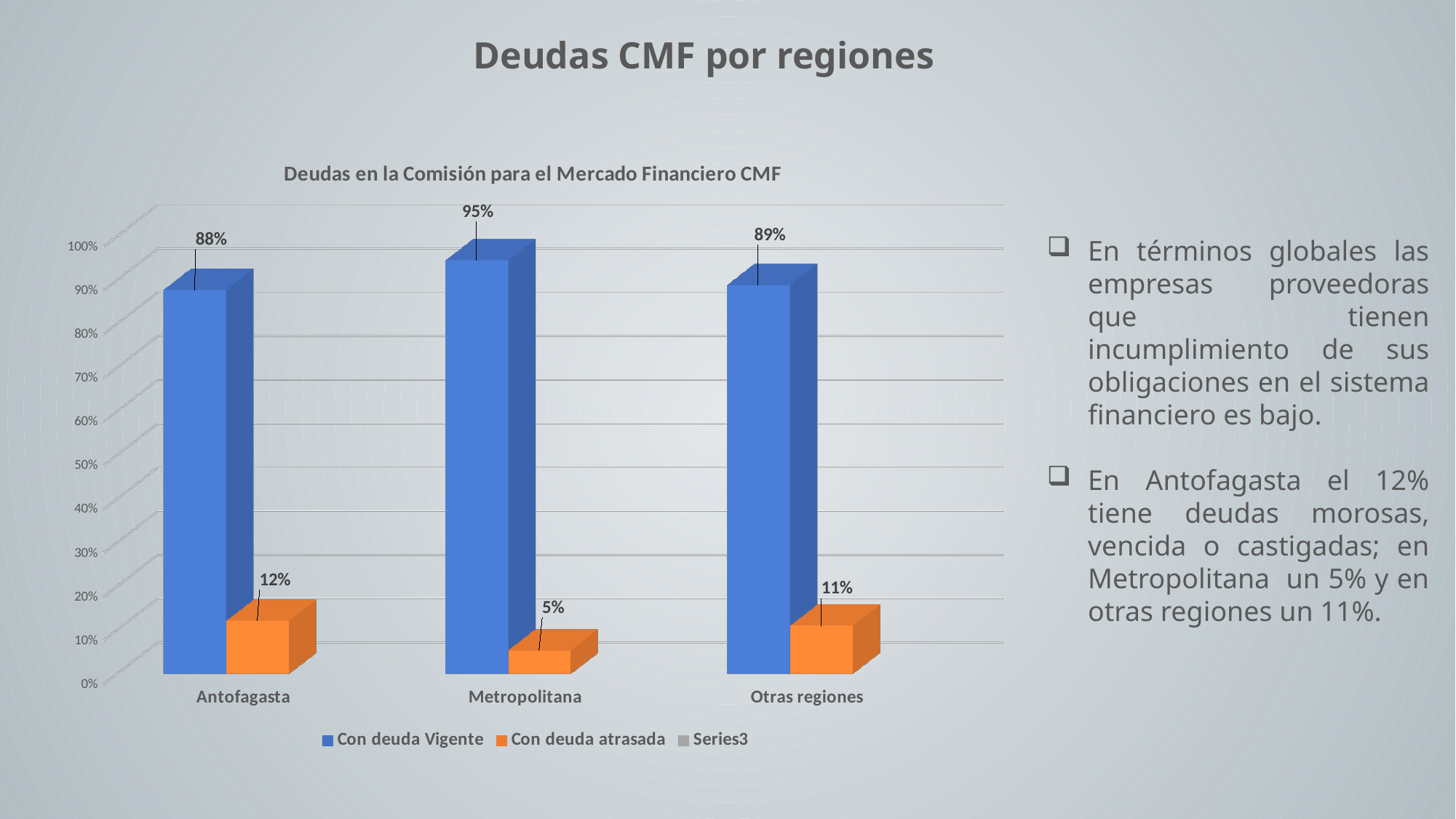
Which region has the highest value for Con deuda Vigente? Metropolitana Which region has the lowest value for Con deuda atrasada? Metropolitana What is the difference between Con deuda Vigente and Con deuda atrasada in Antofagasta? 76% What is the value for Con deuda atrasada in Otras regiones? 11% How many regions are shown on the x axis? 3 What is the value for Con deuda Vigente in Antofagasta? 88% What is the value for Con deuda Vigente in Otras regiones? 89% What is the title of the chart? Deudas en la Comisión para el Mercado Financiero CMF What is the value for Con deuda atrasada in Metropolitana? 5% What kind of chart is shown? Bar chart Which is larger: Con deuda atrasada in Antofagasta or in Otras regiones? Antofagasta How many series does the legend list? 3